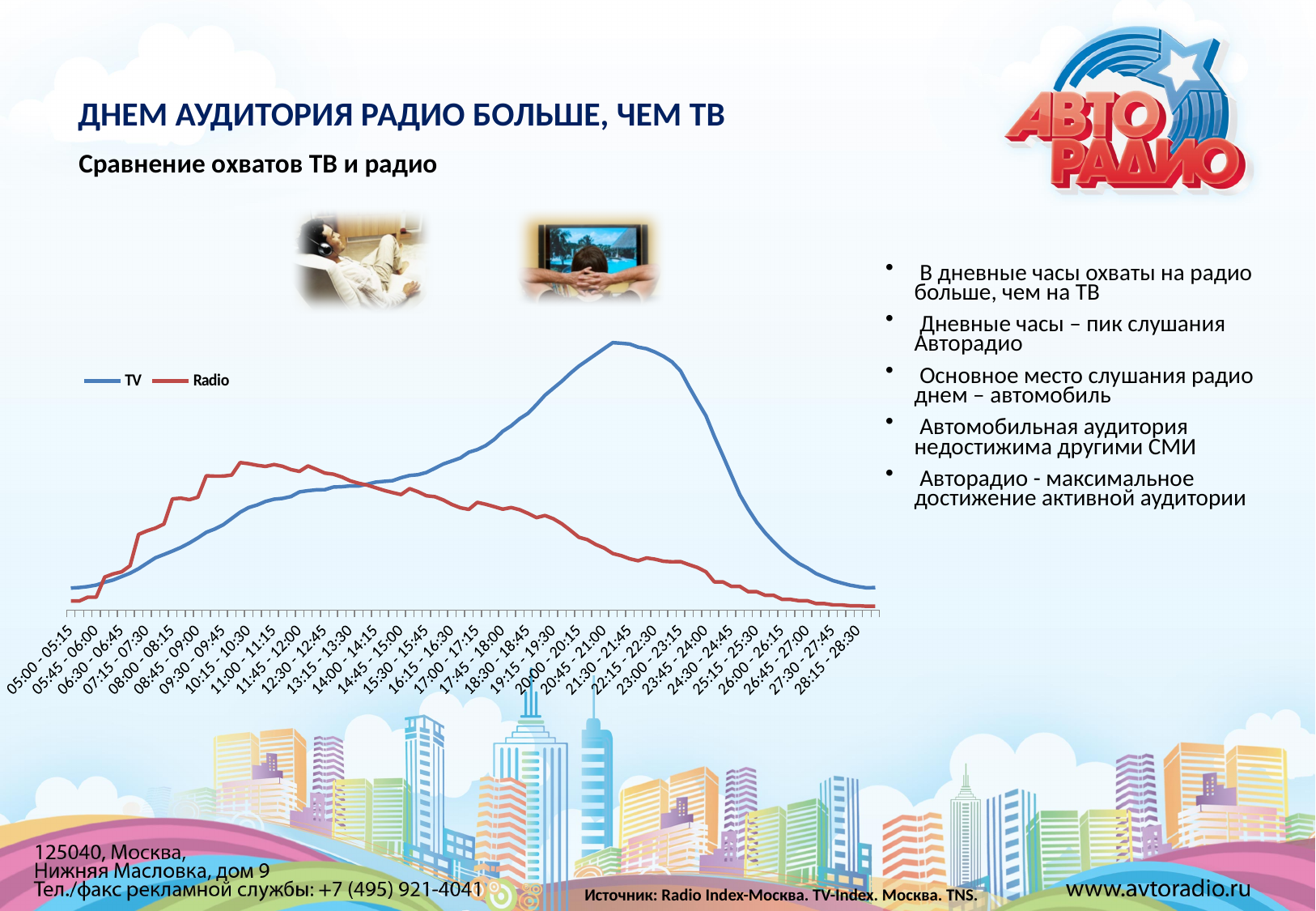
Which series has the higher value at the 18:00 - 18:15 time slot, TV or Radio? TV Which series reaches the higher overall peak in the chart, TV or Radio? TV Does the TV line rise or fall between 05:00 - 05:15 and 21:30 - 21:45? rise Which colour is used for the Radio line in the chart? red Does the Radio line rise or fall between 12:30 - 12:45 and 26:00 - 26:15? fall Which series has the higher value at the 10:15 - 10:30 time slot, TV or Radio? Radio What kind of chart is shown on the slide? line chart How many series does the chart legend list? 2 What are the two series named in the chart legend? TV and Radio How many time-slot labels are shown along the x axis of the chart? 32 Which series has the higher value at the 21:30 - 21:45 time slot, TV or Radio? TV